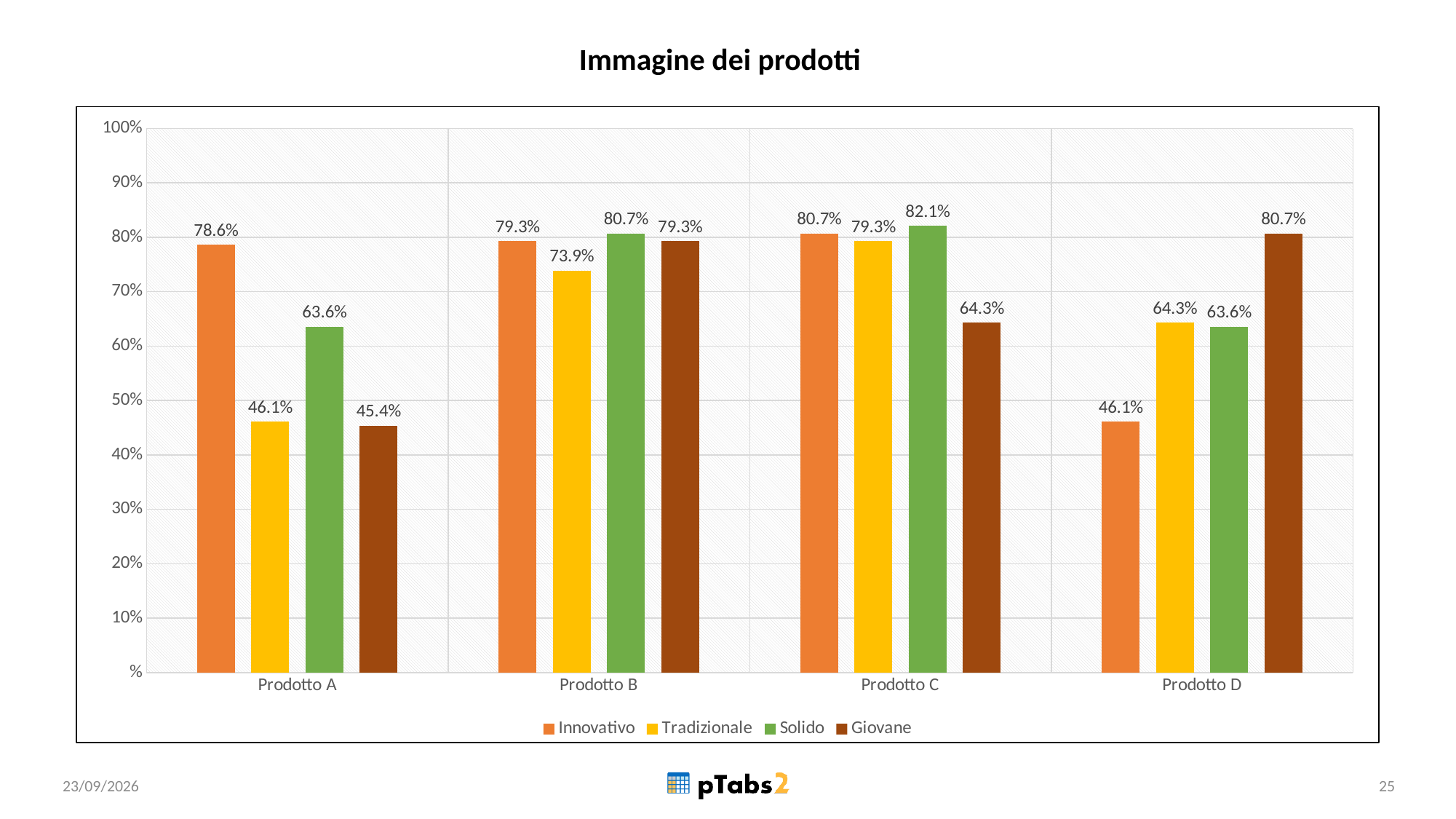
What is the value for Tradizionale for Prodotto B? 73.9% How many product categories are shown on the x axis? 4 What is the title of the chart? Immagine dei prodotti Which series has the lowest value for Prodotto A? Giovane Which is larger for Prodotto C: the Solido value or the Giovane value? Solido What kind of chart is shown on the slide? Bar chart What is the value for Solido for Prodotto C? 82.1% How many series does the legend list? 4 What is the value for Innovativo for Prodotto A? 78.6% Which series has the highest value for Prodotto D? Giovane What is the difference between the Innovativo and Tradizionale values for Prodotto A? 32.5% What is the value for Giovane for Prodotto D? 80.7%